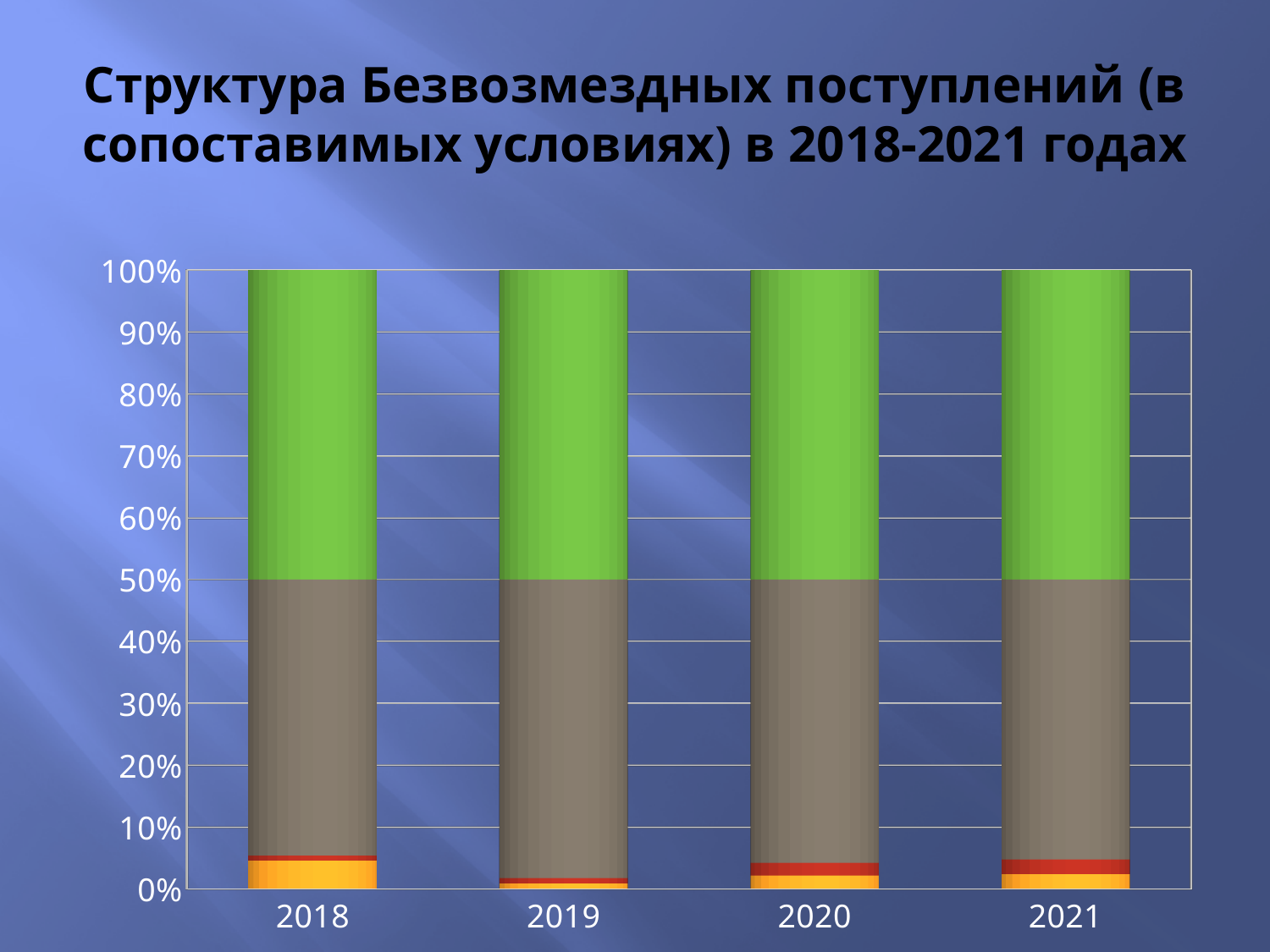
Is the top of the red segment in 2021 greater or less than 10%? less Which year has the larger red segment: 2019 or 2021? 2021 What is the highest value shown on the y axis? 100% Is the top of the brown segment in 2020 greater or less than 60%? less Which colour segment is at the top of each bar? green How many coloured segments make up each bar? 4 In 2018, which segment is larger: the green segment or the red segment? green Is the combined height of the yellow and red segments in 2018 greater or less than 10%? less How many years (categories) are shown on the x axis? 4 What is the title of the chart? Структура Безвозмездных поступлений (в сопоставимых условиях) в 2018-2021 годах What type of chart is shown on the slide? stacked bar chart